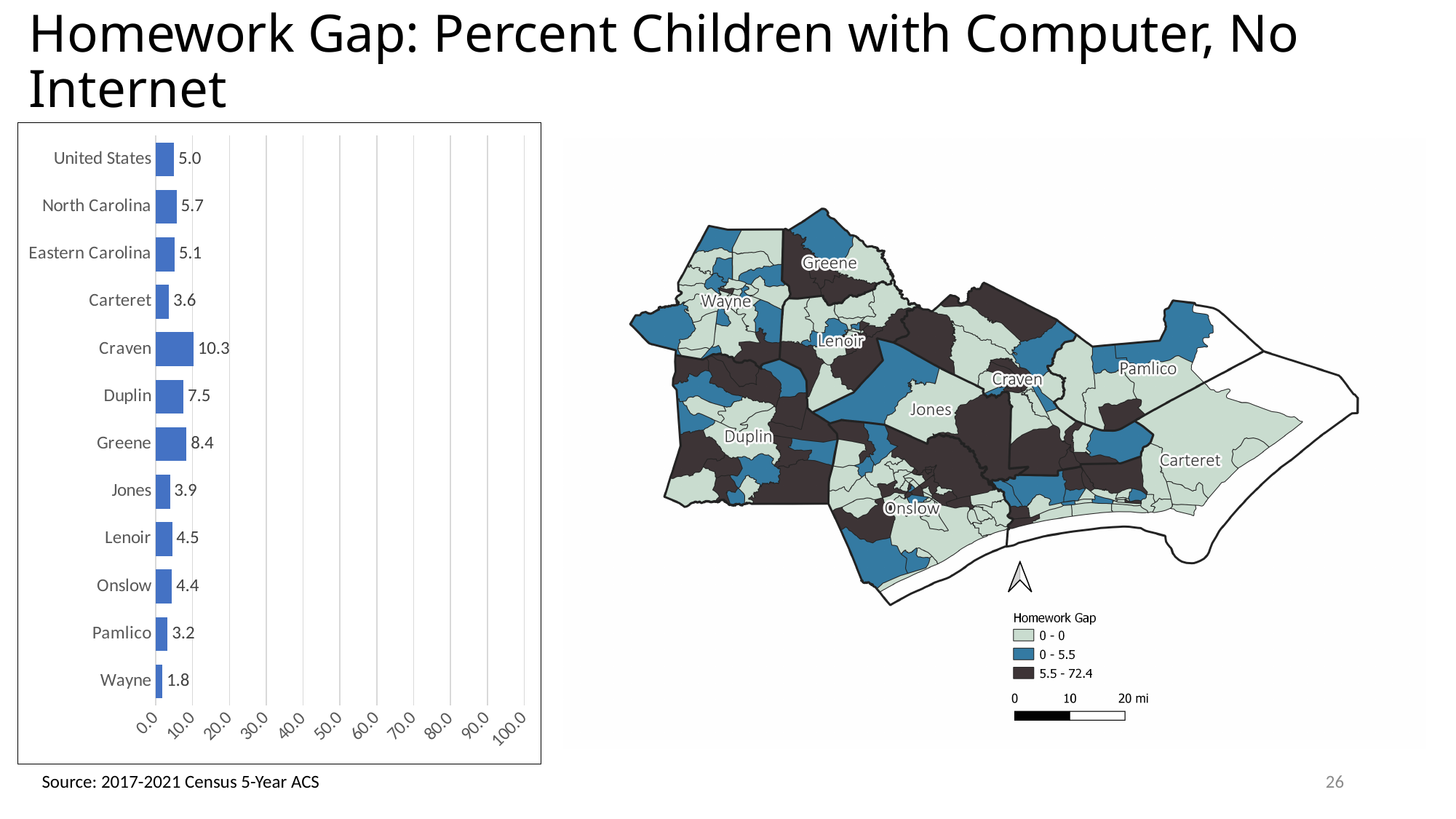
In the bar chart, what is the value for Craven? 10.3 In the bar chart, which category has the highest value? Craven In the bar chart, what is the value for Wayne? 1.8 In the bar chart, which category has the lowest value? Wayne In the bar chart, is the value for Craven greater or less than 20.0? less In the bar chart, which is larger, the value for Duplin or the value for Jones? Duplin In the bar chart, what is the value for Pamlico? 3.2 How many categories are shown in the bar chart? 12 In the bar chart, what is the difference between the values for North Carolina and United States? 0.7 What kind of chart is shown on the left of the slide? bar chart In the bar chart, what is the value for North Carolina? 5.7 In the bar chart, what is the difference between the values for Craven and Wayne? 8.5